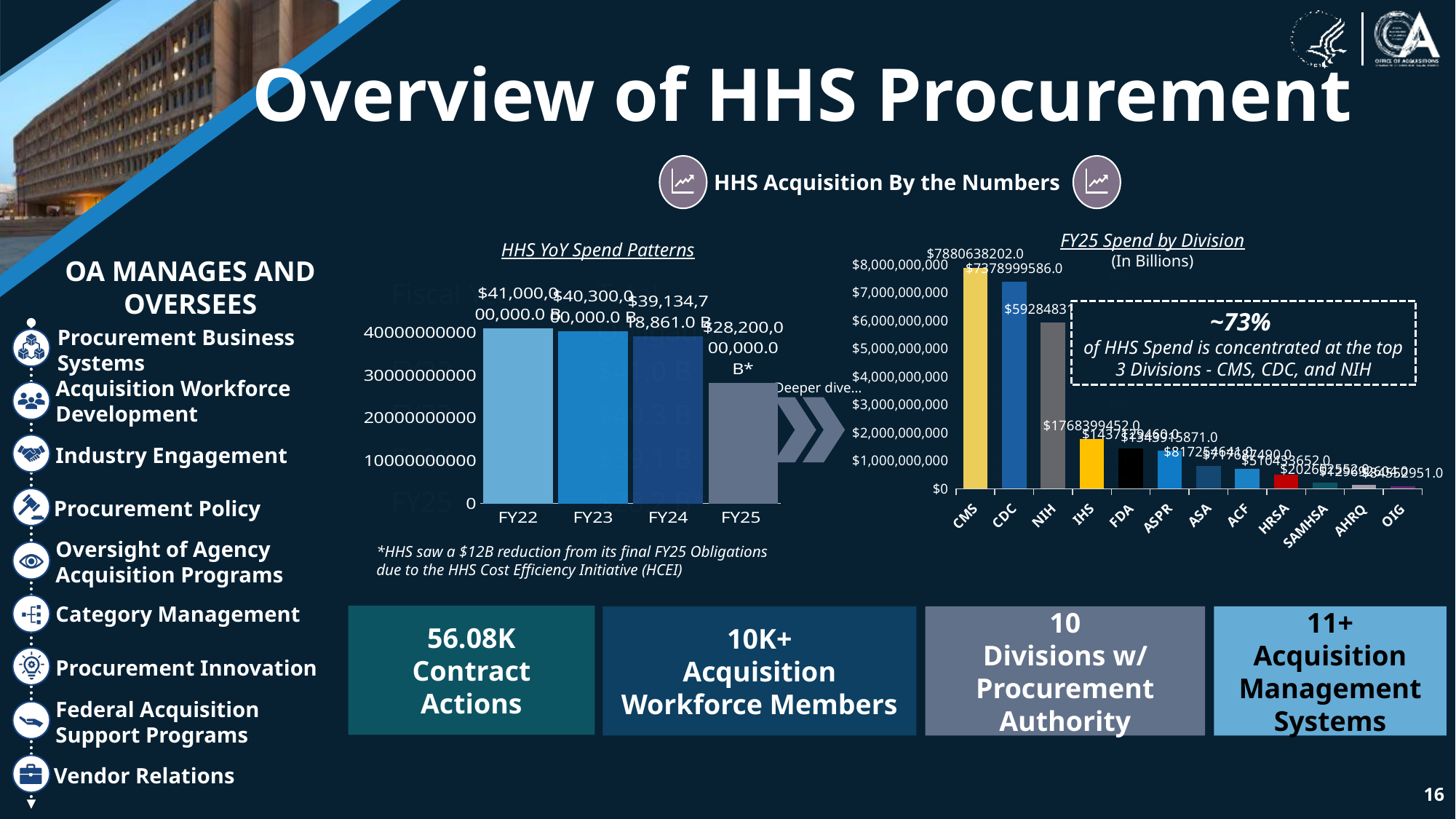
What kind of chart is the 'HHS YoY Spend Patterns' chart? bar chart In the 'HHS YoY Spend Patterns' chart, do the values rise or fall from FY22 to FY25? fall How many divisions are shown in the 'FY25 Spend by Division' chart? 12 In the 'HHS YoY Spend Patterns' chart, is the value for FY25 greater or less than 30000000000? less How many fiscal years are shown in the 'HHS YoY Spend Patterns' chart? 4 In the 'FY25 Spend by Division' chart, is the value for NIH greater or less than $5,000,000,000? greater In the 'HHS YoY Spend Patterns' chart, what is the data label for FY25? $28,200,000,000.0 B* In the 'FY25 Spend by Division' chart, what is the data label for CDC? $7378999586.0 In the 'HHS YoY Spend Patterns' chart, which fiscal year has the highest spend? FY22 In the 'FY25 Spend by Division' chart, which division has the highest spend? CMS In the 'FY25 Spend by Division' chart, what is the data label for CMS? $7880638202.0 In the 'HHS YoY Spend Patterns' chart, which fiscal year has the lowest spend? FY25